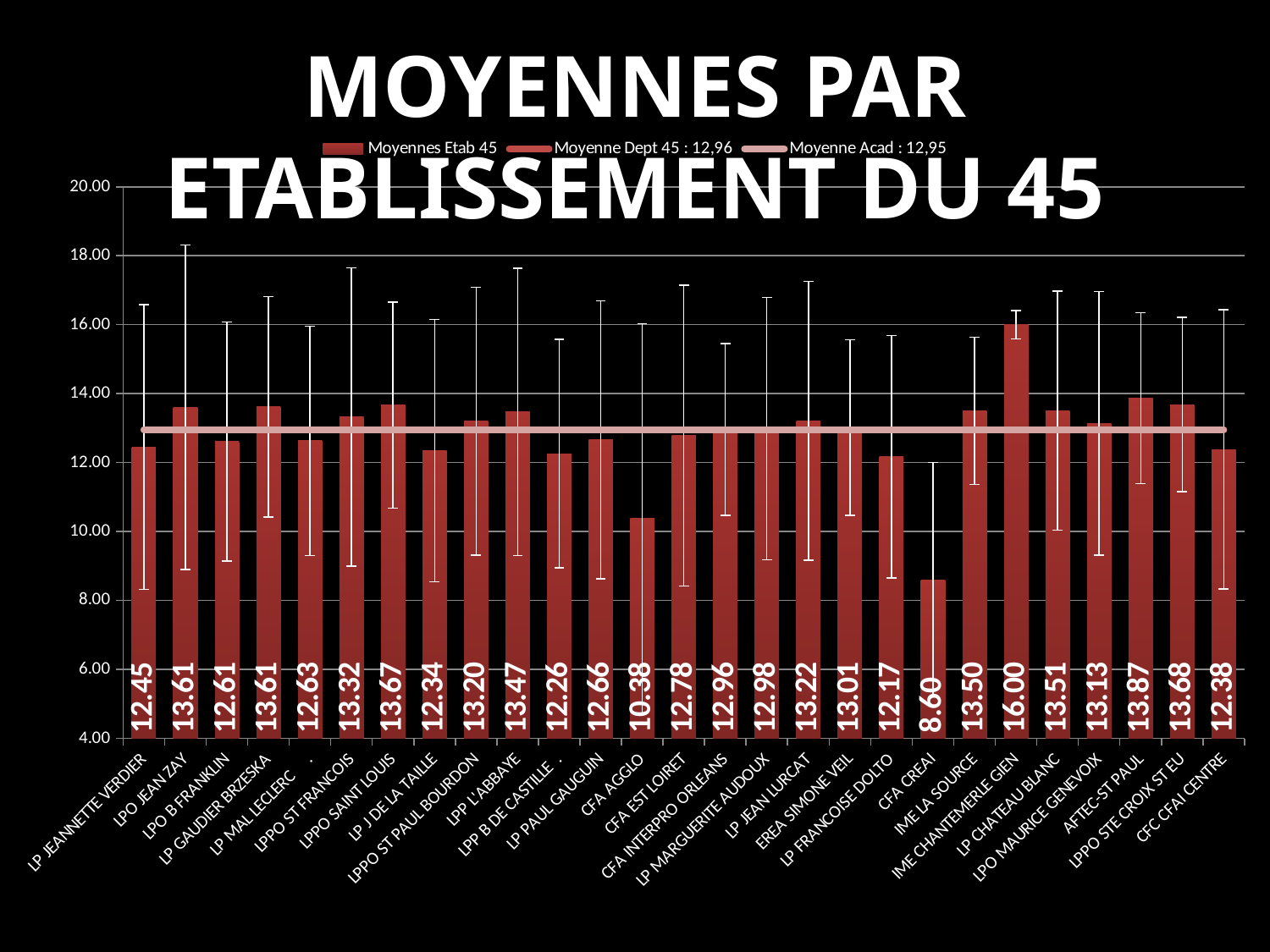
How many series does the legend list? 3 Which establishment has the highest value? IME CHANTEMERLE GIEN What kind of chart is shown on the slide? combination bar and line chart How many establishments are shown on the x axis? 27 What is the value for IME CHANTEMERLE GIEN? 16.00 What is the difference between the values for IME CHANTEMERLE GIEN and CFA CREAI? 7.40 What is the value for LPPO SAINT LOUIS? 13.67 What is the difference between the values for CFA AGGLO and CFA CREAI? 1.78 Which establishment has the lowest value? CFA CREAI Is the value for CFA AGGLO greater or less than 12.00? less What is the value for CFA AGGLO? 10.38